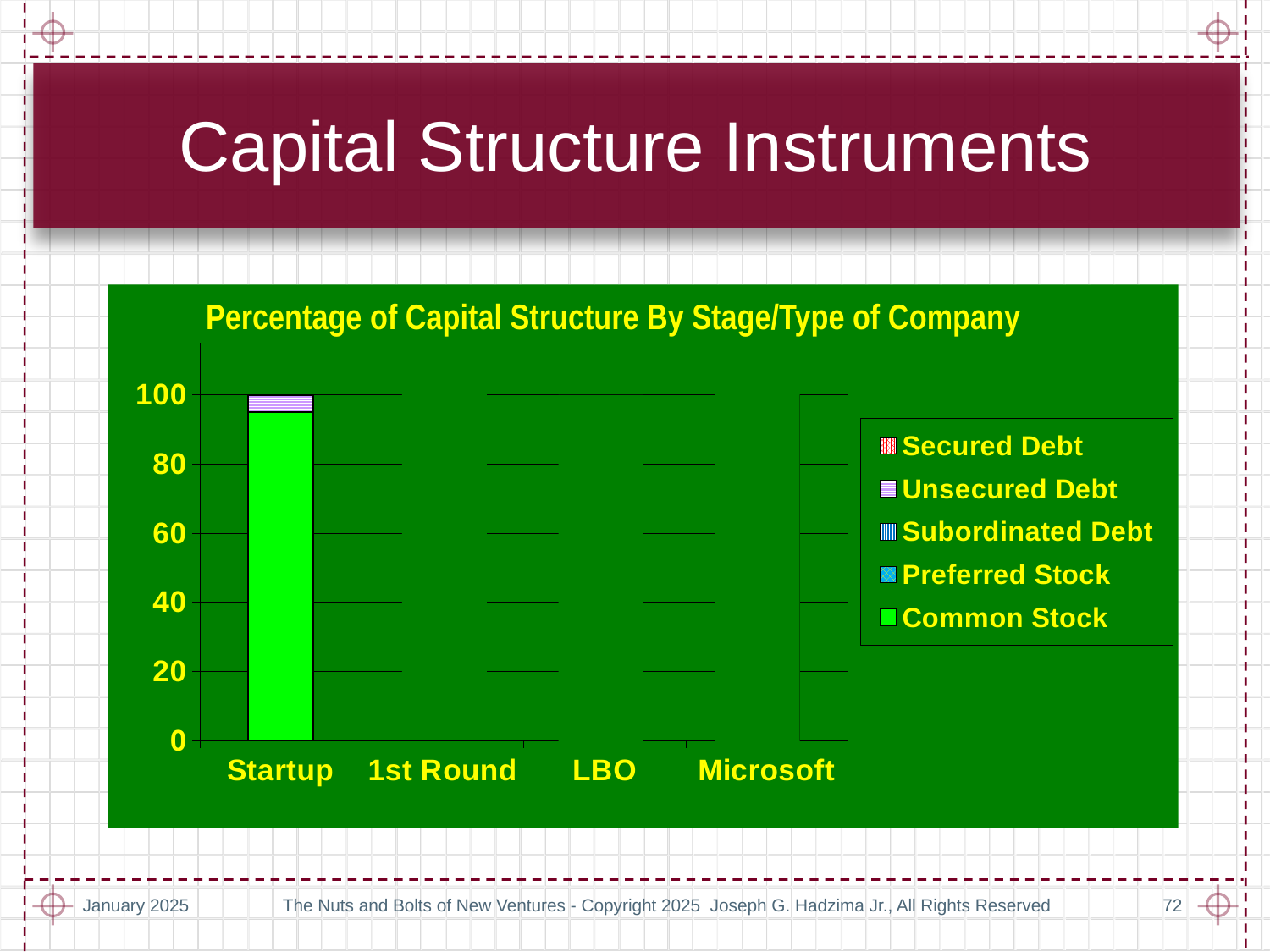
Is the Common Stock value for Startup greater or less than 80? greater Is the Unsecured Debt value for Startup greater or less than 20? less Which series makes up the largest part of the Startup bar? Common Stock What is the title of the chart? Percentage of Capital Structure By Stage/Type of Company What is the total height of the stacked bar for Startup? 100 What is the highest value shown on the y axis of the chart? 100 How many series does the chart legend list? 5 Which series is shown in bright green in the chart legend? Common Stock In the Startup bar, which is larger: Common Stock or Unsecured Debt? Common Stock How many categories are shown on the x axis of the chart? 4 Which category has the tallest bar in the chart? Startup What kind of chart is shown on the slide? bar chart